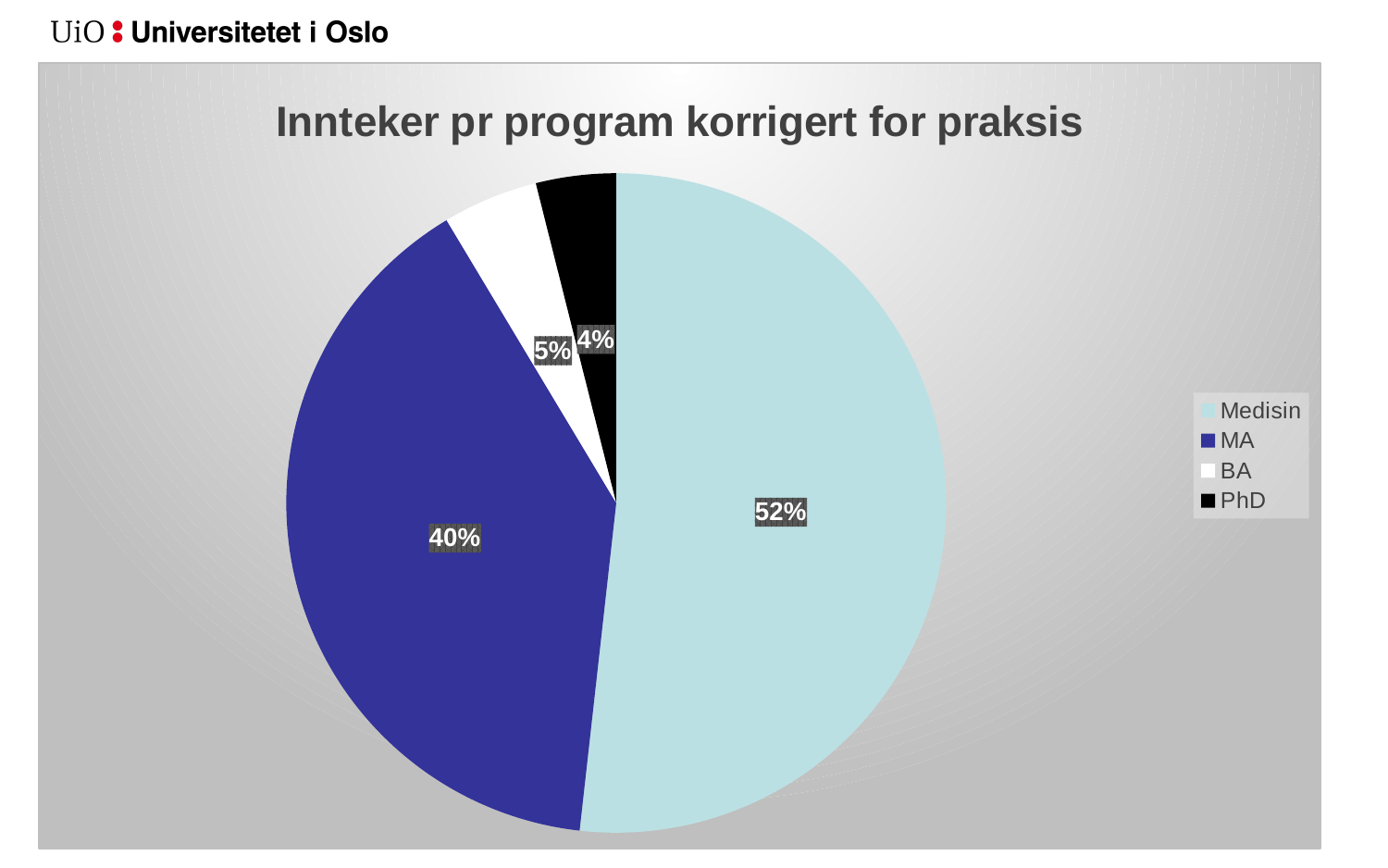
How many categories does the pie chart have? 4 Which category has the largest slice of the pie? Medisin What share of the pie does BA have? 5% What is the difference in percentage points between Medisin and MA? 12 Which colour represents MA in the legend? dark blue What is the title of the chart? Innteker pr program korrigert for praksis What share of the pie does Medisin have? 52% What share of the pie does MA have? 40% Which is larger, the share for BA or the share for PhD? BA What type of chart is shown on the slide? pie chart Which category has the smallest slice of the pie? PhD